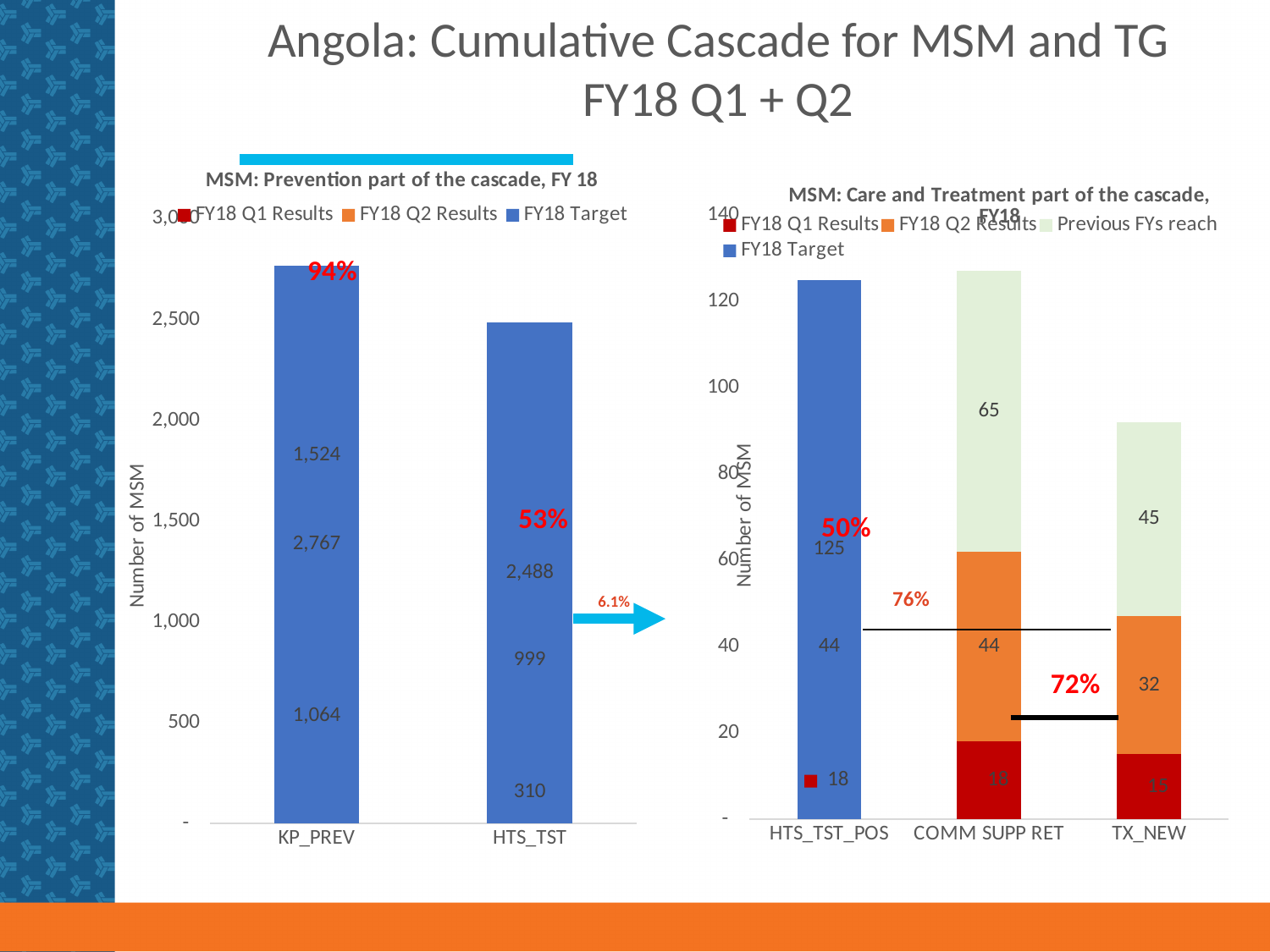
In the right chart, 'MSM: Care and Treatment part of the cascade, FY18', what is the FY18 Q2 Results value for TX_NEW? 32 In the right chart, 'MSM: Care and Treatment part of the cascade, FY18', what is the difference between the Previous FYs reach values for COMM SUPP RET and TX_NEW? 20 In the right chart, 'MSM: Care and Treatment part of the cascade, FY18', which category has the larger FY18 Q2 Results value, COMM SUPP RET or TX_NEW? COMM SUPP RET In the right chart, 'MSM: Care and Treatment part of the cascade, FY18', what is the FY18 Target value for HTS_TST_POS? 125 In the right chart, 'MSM: Care and Treatment part of the cascade, FY18', what is the Previous FYs reach value for COMM SUPP RET? 65 How many series does the legend of the left chart, 'MSM: Prevention part of the cascade, FY 18', list? 3 How many categories are shown on the x axis of the right chart, 'MSM: Care and Treatment part of the cascade, FY18'? 3 What kind of chart is the left chart, 'MSM: Prevention part of the cascade, FY 18'? bar chart In the left chart, 'MSM: Prevention part of the cascade, FY 18', what percentage label is shown in red above the HTS_TST bar? 53% How many categories are shown on the x axis of the left chart, 'MSM: Prevention part of the cascade, FY 18'? 2 In the right chart, 'MSM: Care and Treatment part of the cascade, FY18', what is the total of the stacked bar for TX_NEW? 92 How many series does the legend of the right chart, 'MSM: Care and Treatment part of the cascade, FY18', list? 4